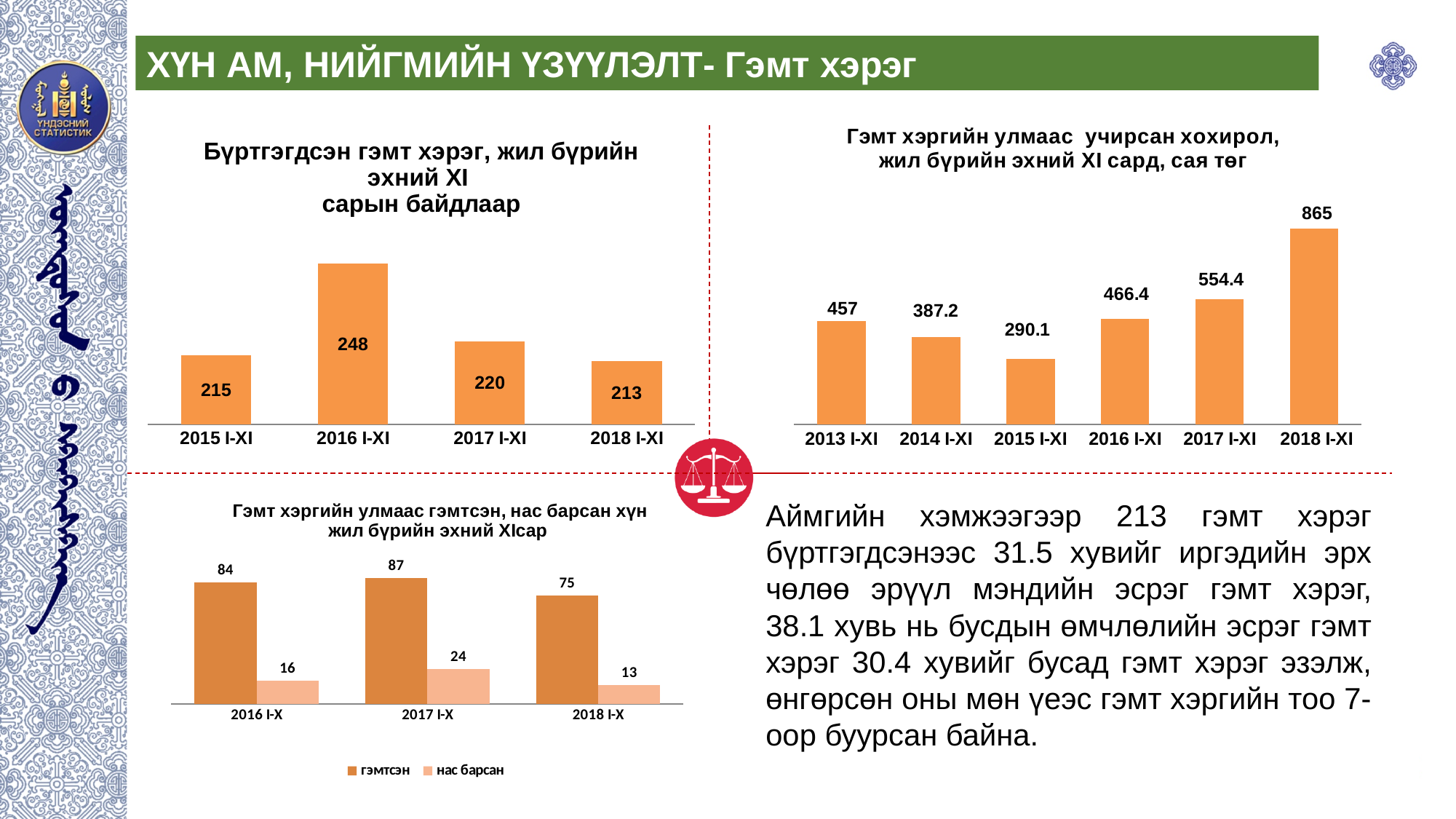
In the top-right chart (Гэмт хэргийн улмаас учирсан хохирол), which category has the highest value? 2018 I-XI In the bottom-left chart (Гэмт хэргийн улмаас гэмтсэн, нас барсан хүн), what is the value of нас барсан for 2017 I-X? 24 In the top-right chart (Гэмт хэргийн улмаас учирсан хохирол), what is the value for 2014 I-XI? 387.2 What type of chart is the bottom-left chart (Гэмт хэргийн улмаас гэмтсэн, нас барсан хүн)? Bar chart How many series does the legend of the bottom-left chart (Гэмт хэргийн улмаас гэмтсэн, нас барсан хүн) list? 2 In the top-right chart (Гэмт хэргийн улмаас учирсан хохирол), which is larger: the value for 2013 I-XI or 2016 I-XI? 2016 I-XI How many bars are in the top-left chart (Бүртгэгдсэн гэмт хэрэг)? 4 In the top-left chart (Бүртгэгдсэн гэмт хэрэг), which category has the lowest value? 2018 I-XI In the top-right chart (Гэмт хэргийн улмаас учирсан хохирол), which category has the lowest value? 2015 I-XI In the top-left chart (Бүртгэгдсэн гэмт хэрэг), what is the difference between the values for 2016 I-XI and 2018 I-XI? 35 In the top-left chart (Бүртгэгдсэн гэмт хэрэг), what is the value for 2016 I-XI? 248 How many categories are shown in the top-right chart (Гэмт хэргийн улмаас учирсан хохирол)? 6